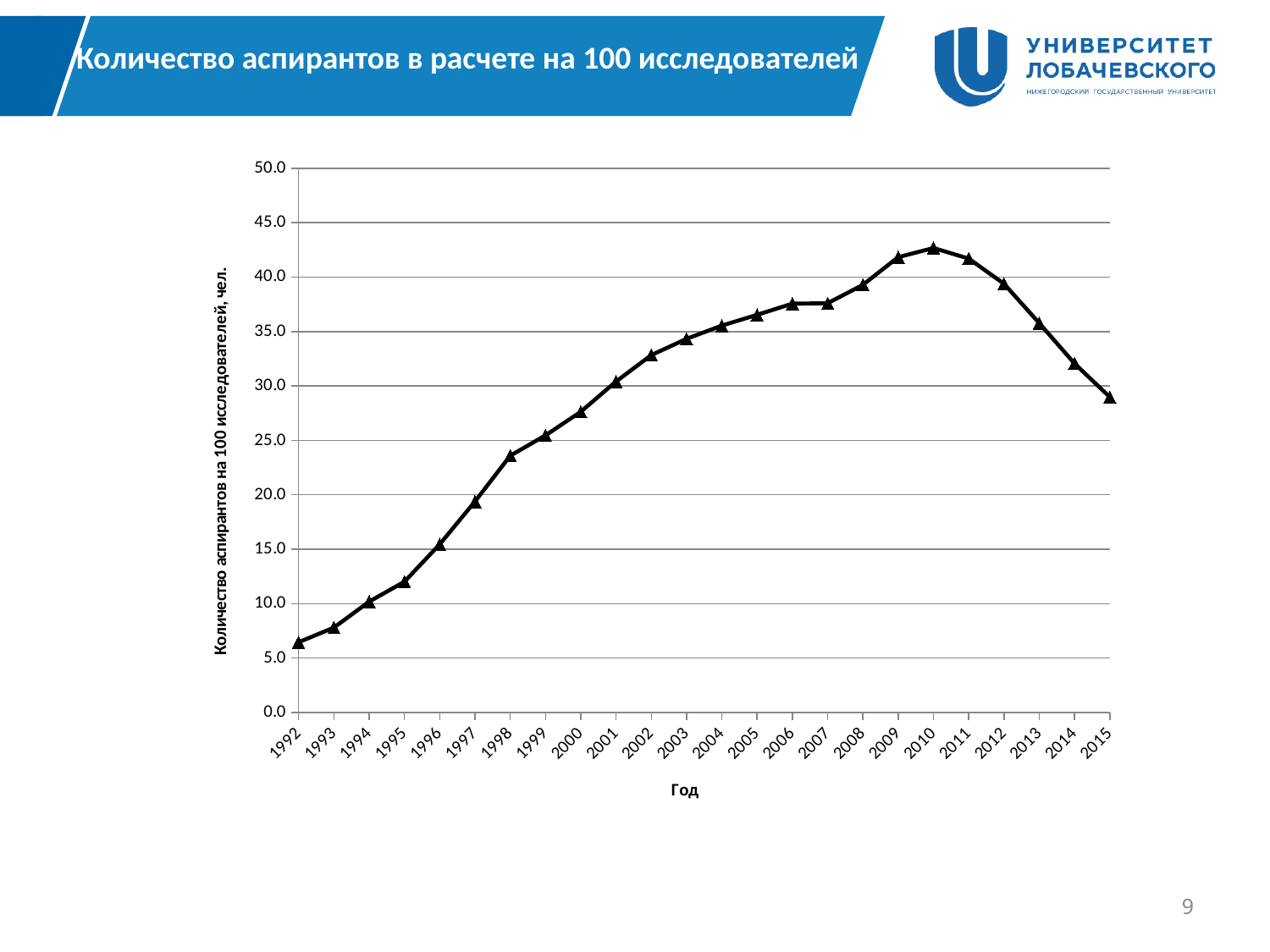
What kind of chart is shown on the slide? line chart Is the value for 2014 greater or less than 30? greater In which year is the number of postgraduates per 100 researchers highest? 2010 How many years are plotted along the x axis? 24 Which year has the larger value, 2010 or 2015? 2010 Is the value for 2010 greater or less than 40? greater In which year is the number of postgraduates per 100 researchers lowest? 1992 Which year has the larger value, 1992 or 2000? 2000 What is the title of the x axis? Год Is the value for 2000 greater or less than 30? less Do the values rise or fall from 2010 to 2015? fall